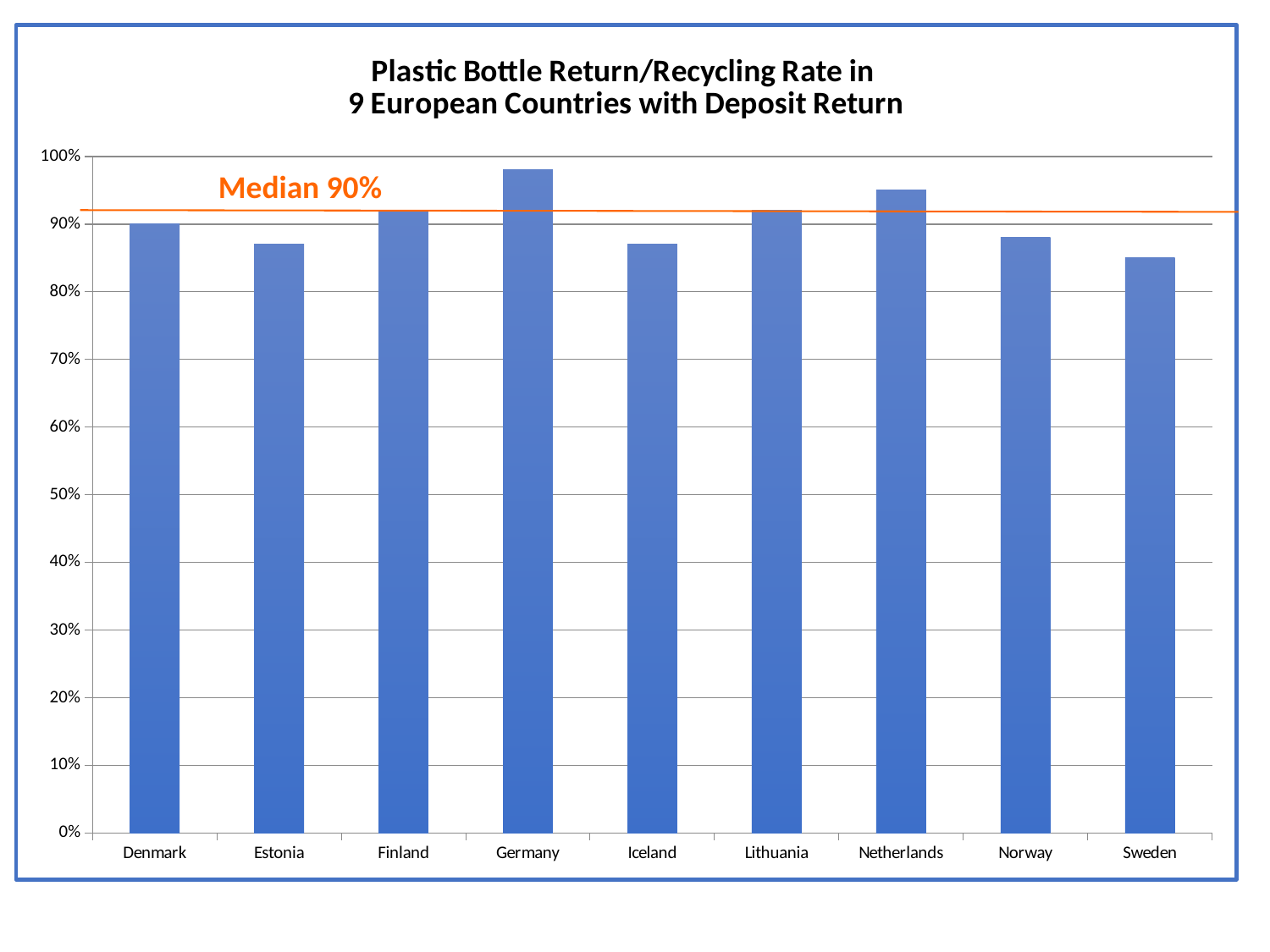
Is the value for Sweden greater or less than 90%? less Is the value for Estonia greater or less than 80%? greater What kind of chart is shown on the slide? Bar chart Which has a higher return/recycling rate, Netherlands or Norway? Netherlands How many countries are shown on the x axis of the chart? 9 Is the value for Germany greater or less than 90%? greater What median value is marked by the orange line on the chart? 90% Which country has the highest plastic bottle return/recycling rate? Germany Which has a higher return/recycling rate, Germany or Sweden? Germany What is the plastic bottle return/recycling rate for Denmark? 90%